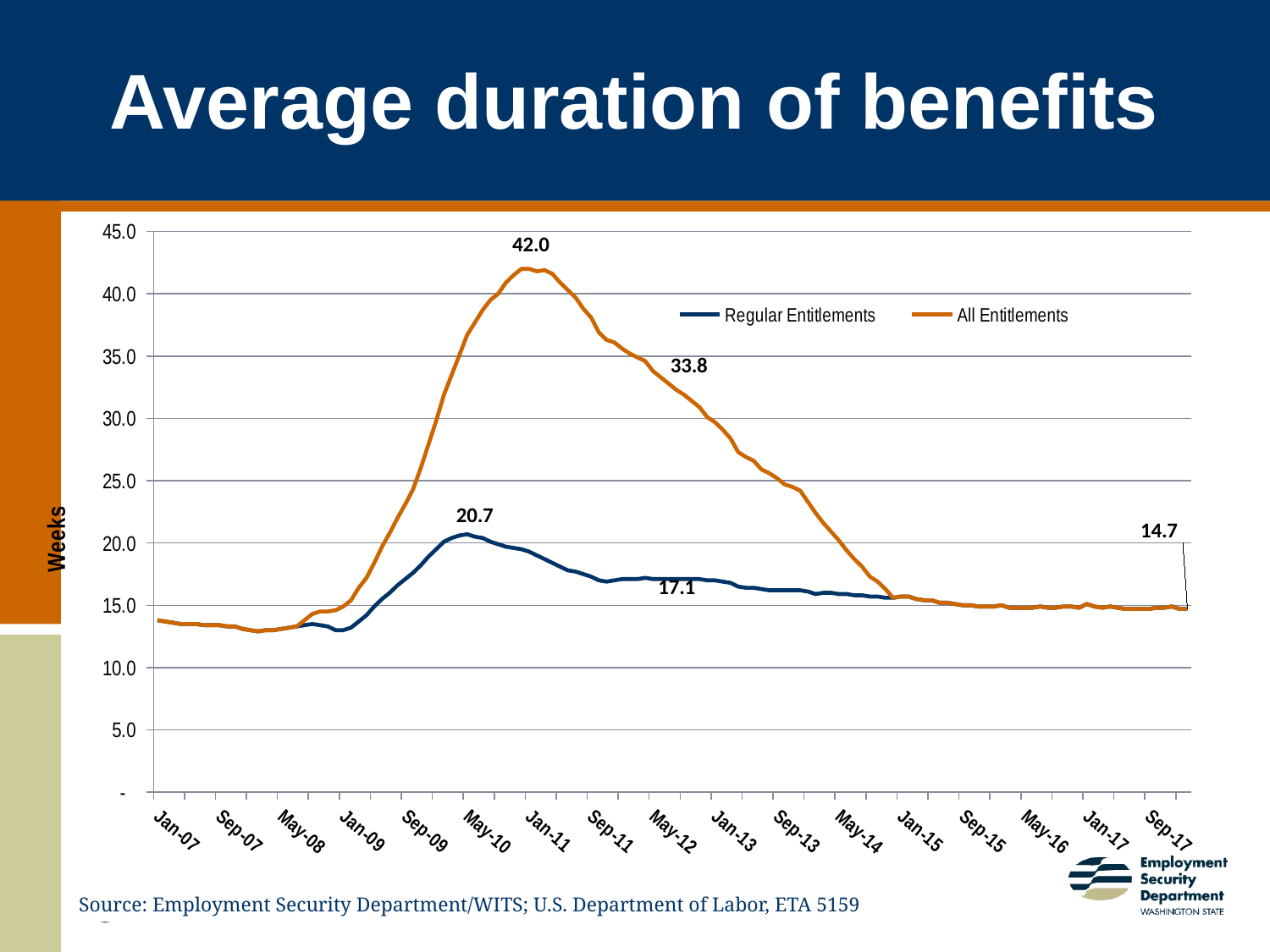
What is the difference between the labelled peak of All Entitlements (42.0) and the labelled peak of Regular Entitlements (20.7)? 21.3 What is the label on the vertical axis? Weeks What kind of chart is shown on the slide? line chart What is the peak value labelled on the Regular Entitlements line? 20.7 What colour is the All Entitlements line? orange What is the peak value labelled on the All Entitlements line? 42.0 Is the value for Regular Entitlements at Jan-09 greater or less than 15.0? less Which series reaches the higher peak, Regular Entitlements or All Entitlements? All Entitlements How many series does the legend list? 2 Does the All Entitlements line rise or fall between Jan-11 and Jan-15? fall What value is labelled at the right end of the chart, near Sep-17? 14.7 What is the difference between the labelled values 33.8 (All Entitlements) and 17.1 (Regular Entitlements)? 16.7